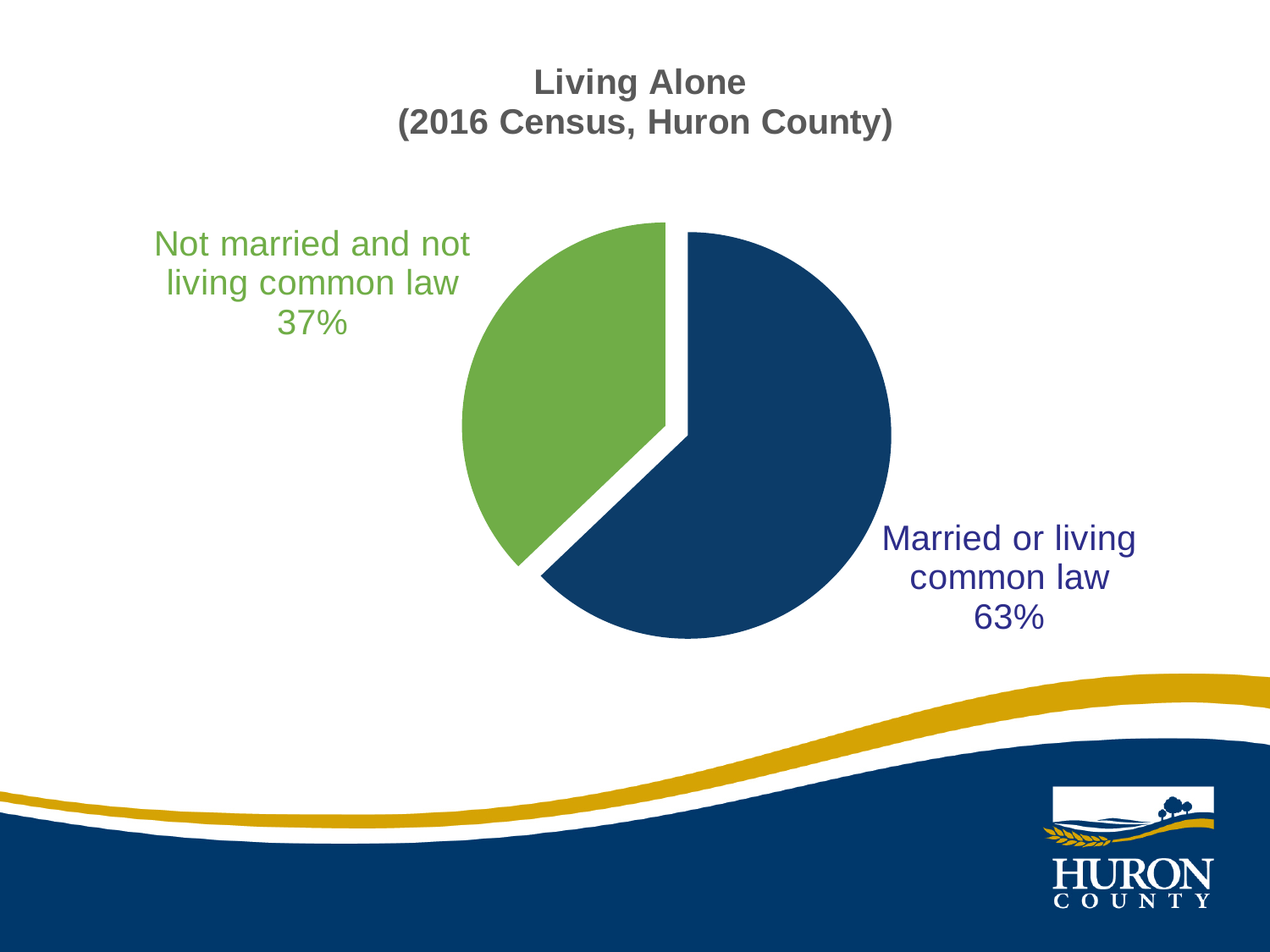
What is the title of the chart? Living Alone (2016 Census, Huron County) Which category has the smallest share of the pie? Not married and not living common law What colour is the 'Not married and not living common law' slice? green What is the difference in percentage points between 'Married or living common law' and 'Not married and not living common law'? 26 What percentage of the pie is 'Married or living common law'? 63% Which is larger: the share for 'Married or living common law' or the share for 'Not married and not living common law'? Married or living common law How many slices does the pie chart have? 2 What percentage of the pie is 'Not married and not living common law'? 37% What is the total of the two slice percentages shown? 100% Which category has the largest share of the pie? Married or living common law What type of chart is shown on the slide? pie chart